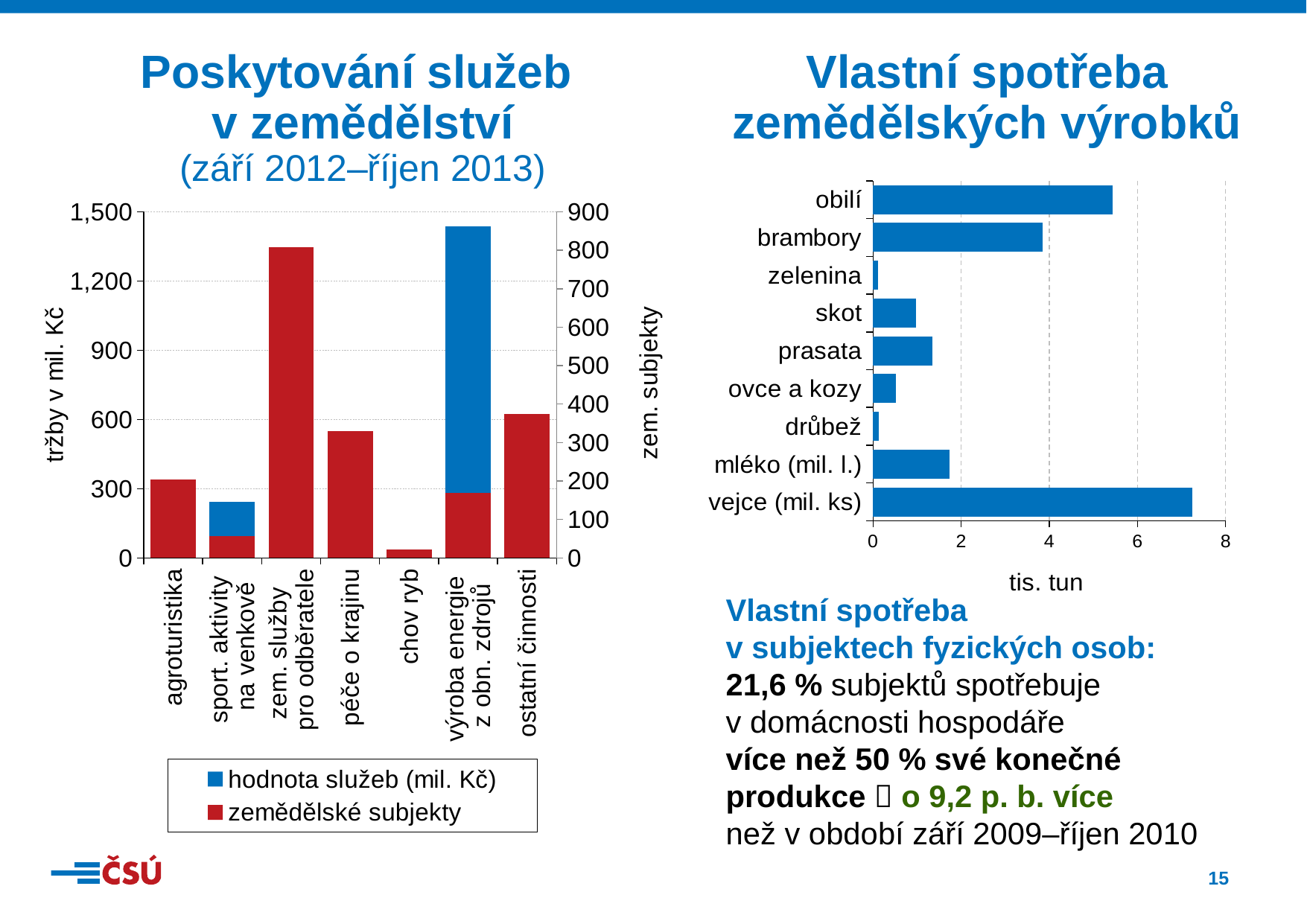
How many series does the legend of the 'Poskytování služeb v zemědělství' chart list? 2 In the 'Vlastní spotřeba zemědělských výrobků' chart, is the value for obilí greater or less than 4? greater In the 'Vlastní spotřeba zemědělských výrobků' chart, how many categories are shown? 9 In the 'Poskytování služeb v zemědělství' chart, is the 'hodnota služeb (mil. Kč)' value for výroba energie z obn. zdrojů greater or less than 1,200? greater In the 'Vlastní spotřeba zemědělských výrobků' chart, which is larger: obilí or brambory? obilí In the 'Vlastní spotřeba zemědělských výrobků' chart, is the value for skot greater or less than 2? less What is the x-axis unit label on the 'Vlastní spotřeba zemědělských výrobků' chart? tis. tun How many categories are shown on the x axis of the 'Poskytování služeb v zemědělství' chart? 7 What kind of chart is the 'Vlastní spotřeba zemědělských výrobků' chart? bar chart In the 'Vlastní spotřeba zemědělských výrobků' chart, which category has the highest value? vejce (mil. ks)